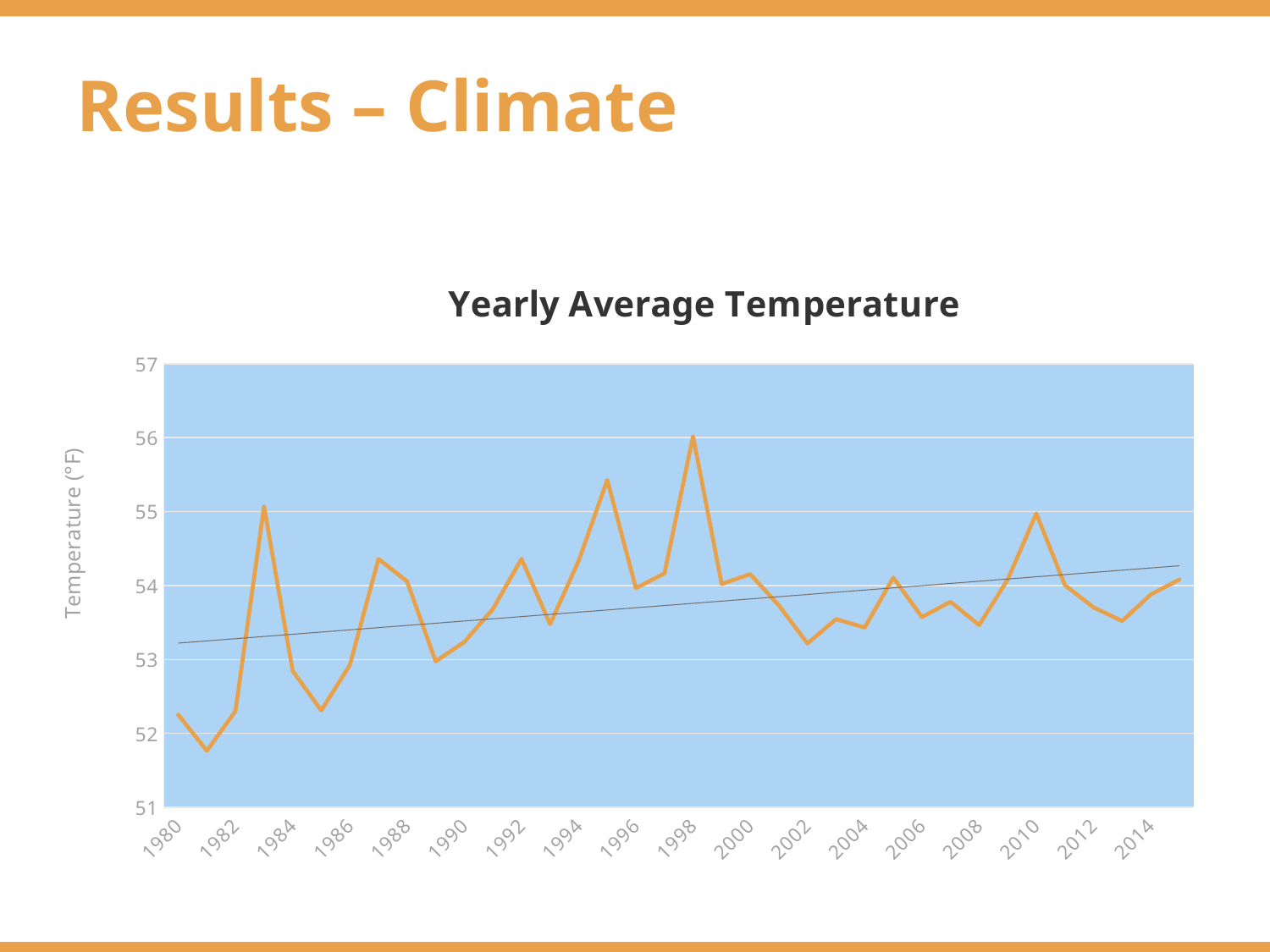
According to the trend line, does the yearly average temperature generally rise or fall from 1980 to 2015? rise What is the label on the vertical axis of the chart? Temperature (°F) Which year has the higher yearly average temperature, 1983 or 1984? 1983 In which year does the yearly average temperature reach its lowest value? 1981 Is the value for 2002 greater or less than 54? less Is the value for 1981 greater or less than 52? less Is the value for 1998 greater or less than 55? greater Which year has the higher yearly average temperature, 1995 or 1998? 1998 What is the title of the chart? Yearly Average Temperature In which year does the yearly average temperature reach its highest value? 1998 What kind of chart is shown on the slide? line chart